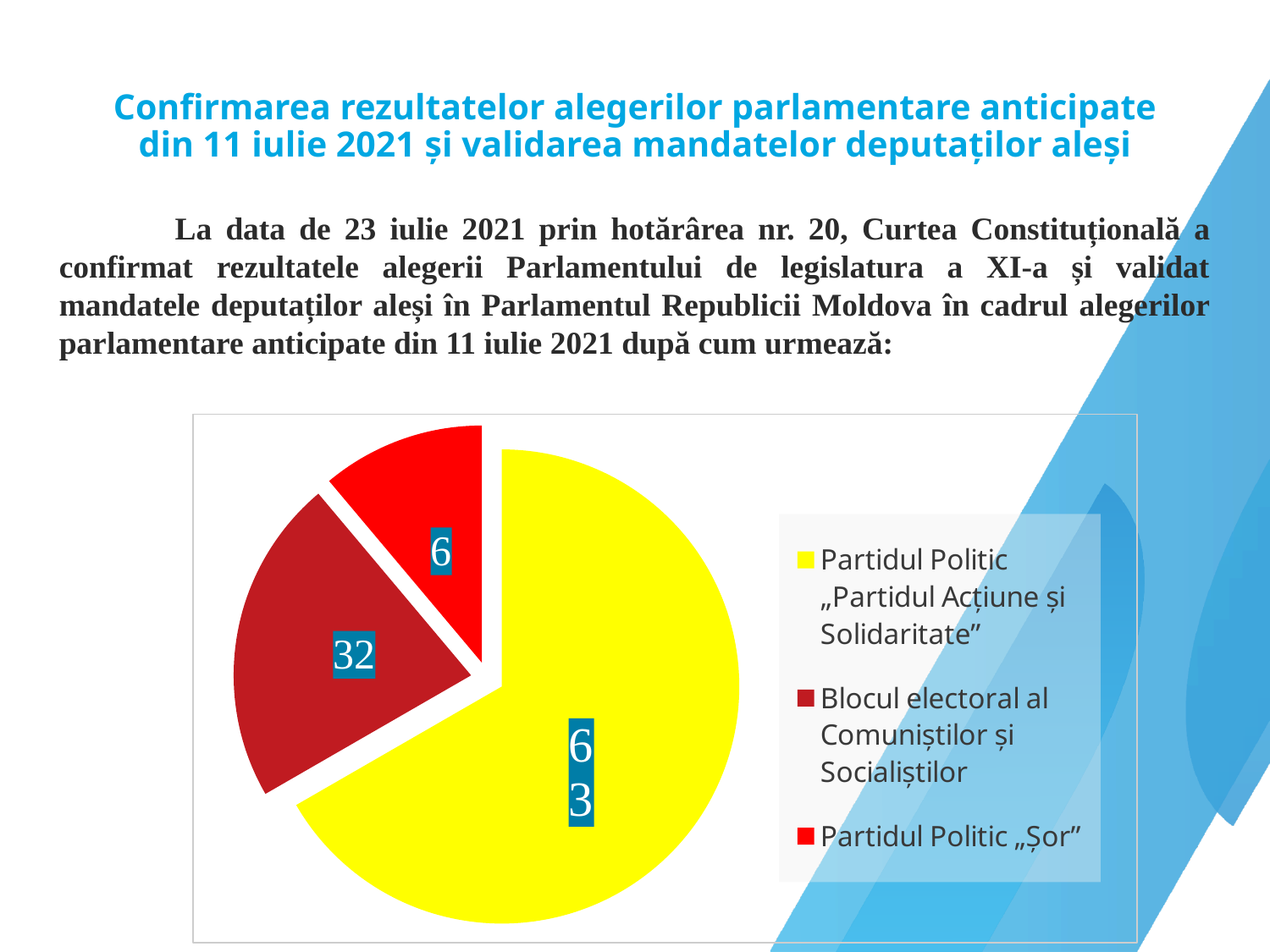
How many mandates does the chart show for Partidul Politic „Partidul Acțiune și Solidaritate”? 63 Which party has the largest slice of the pie? Partidul Politic „Partidul Acțiune și Solidaritate” How many slices does the pie chart have? 3 Which has more mandates, Blocul electoral al Comuniștilor și Socialiștilor or Partidul Politic „Șor”? Blocul electoral al Comuniștilor și Socialiștilor How many mandates does the chart show for Blocul electoral al Comuniștilor și Socialiștilor? 32 What colour is the slice for Partidul Politic „Partidul Acțiune și Solidaritate”? yellow What kind of chart is shown on the slide? pie chart Which party has the smallest slice of the pie? Partidul Politic „Șor” How many mandates does the chart show for Partidul Politic „Șor”? 6 What is the difference in mandates between Blocul electoral al Comuniștilor și Socialiștilor and Partidul Politic „Șor”? 26 What is the difference in mandates between Partidul Politic „Partidul Acțiune și Solidaritate” and Blocul electoral al Comuniștilor și Socialiștilor? 31 What is the total number of mandates shown across all slices of the pie chart? 101